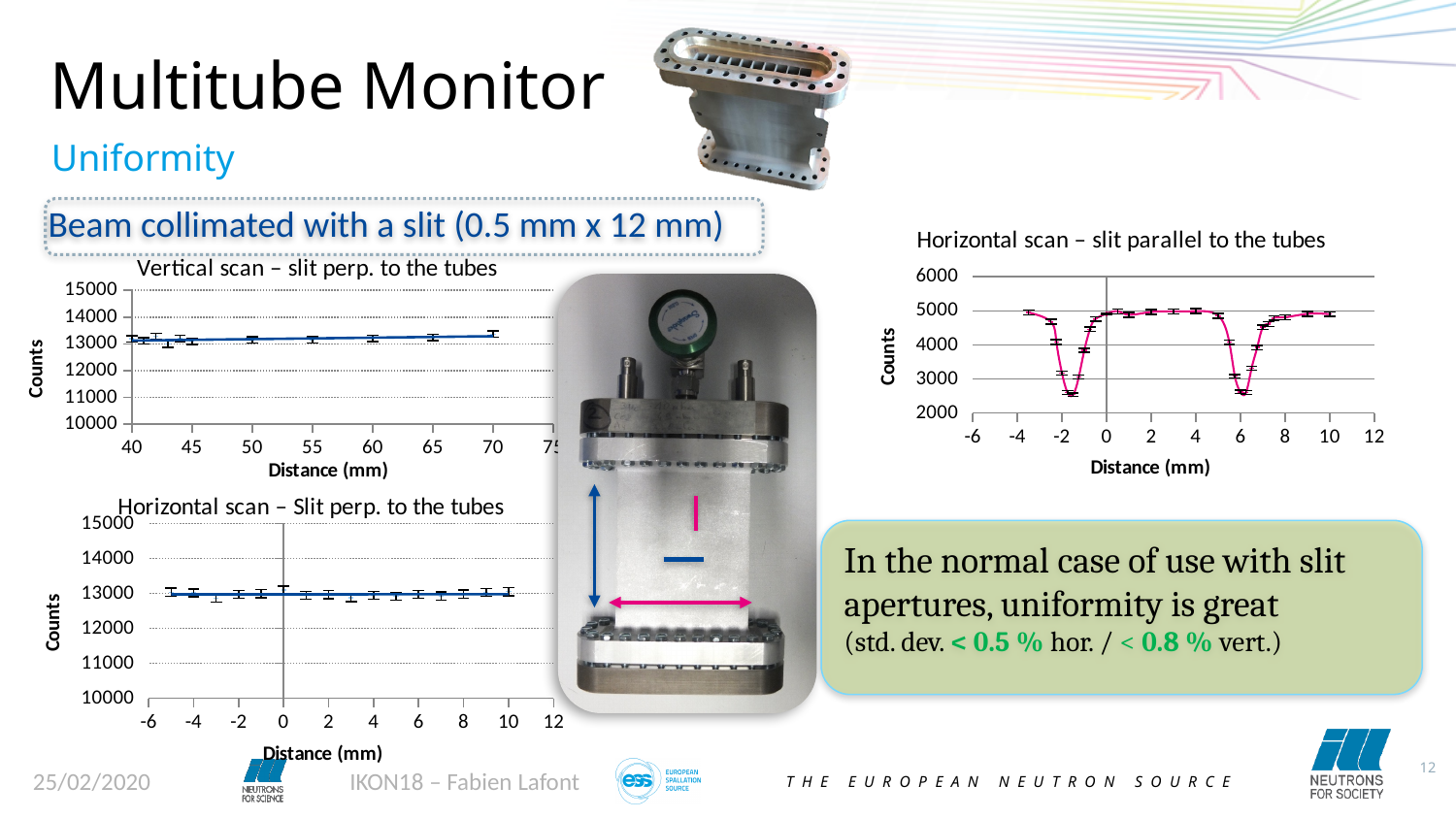
In the 'Horizontal scan – slit parallel to the tubes' chart, what is the lowest value shown on the y axis? 2000 How many charts are shown on the slide? 3 In the 'Horizontal scan – slit parallel to the tubes' chart, do the counts rise or fall between distance 0 mm and -2 mm? fall In the 'Vertical scan – slit perp. to the tubes' chart, is the value at distance 60 mm greater or less than 12000? greater What kind of chart is the 'Vertical scan – slit perp. to the tubes' chart? line chart What is the y-axis label of the 'Horizontal scan – slit parallel to the tubes' chart? Counts In the 'Horizontal scan – Slit perp. to the tubes' chart (bottom left), do the counts rise, fall, or stay roughly flat as distance increases from -6 to 10 mm? stay roughly flat What is the x-axis label of the 'Vertical scan – slit perp. to the tubes' chart? Distance (mm) In the 'Horizontal scan – Slit perp. to the tubes' chart (bottom left), is the value at distance 0 mm greater or less than 14000? less In the 'Horizontal scan – slit parallel to the tubes' chart, is the value at distance 6 mm greater or less than 3000? less